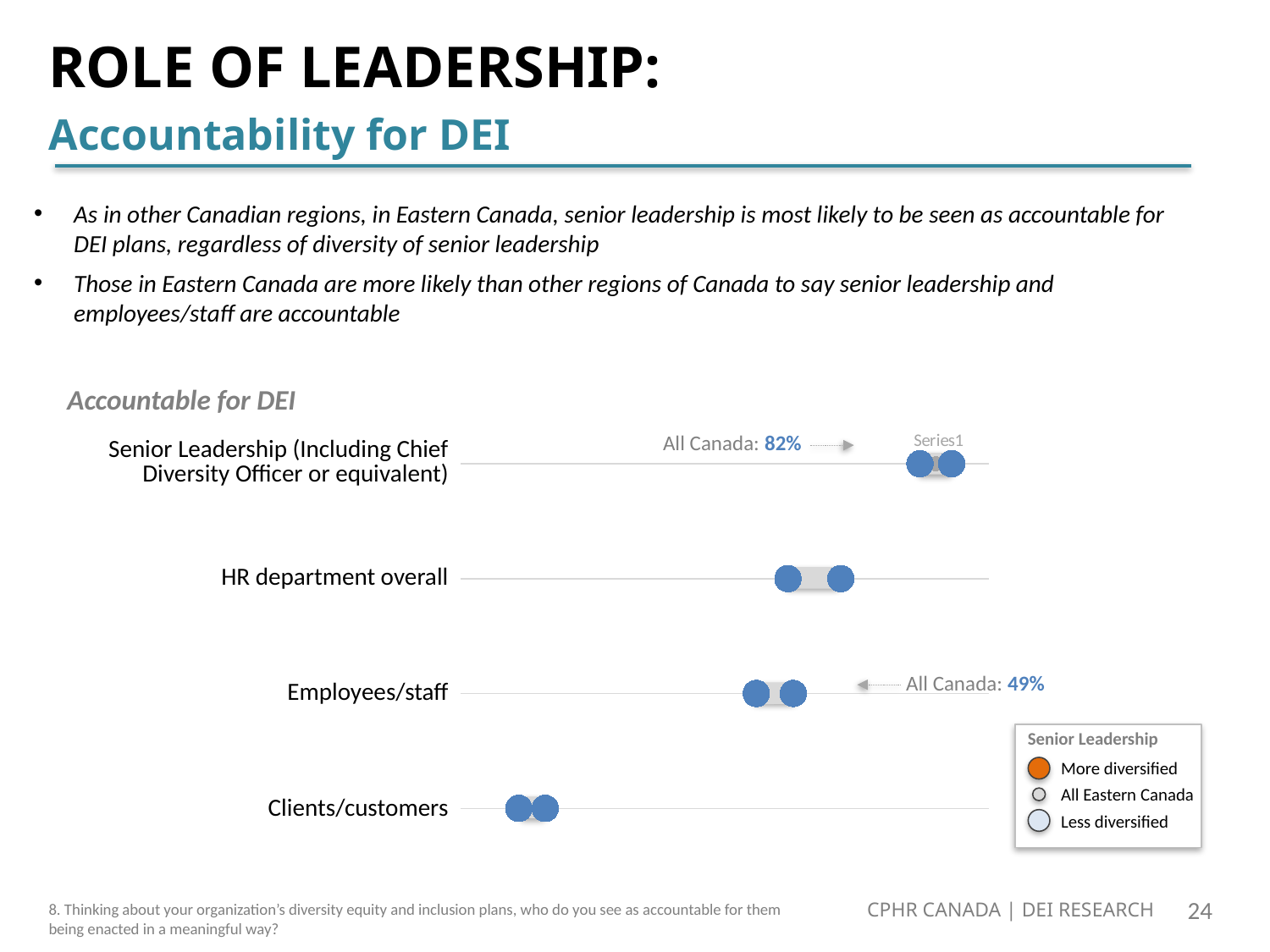
In the Accountable for DEI chart, which category has higher values: Clients/customers or Employees/staff? Employees/staff What All Canada value is annotated for Employees/staff in the Accountable for DEI chart? 49% What is the title of the chart on the slide? Accountable for DEI Which category in the Accountable for DEI chart has its markers positioned furthest to the right (highest)? Senior Leadership (Including Chief Diversity Officer or equivalent) How many categories are plotted in the Accountable for DEI chart? 4 In the Accountable for DEI chart, which category has higher values: HR department overall or Employees/staff? HR department overall What are the three entries listed in the Senior Leadership legend of the Accountable for DEI chart? More diversified, All Eastern Canada, Less diversified Which category in the Accountable for DEI chart has its markers positioned furthest to the left (lowest)? Clients/customers In the Accountable for DEI chart, what is the difference between the All Canada value for Senior Leadership (82%) and the All Canada value for Employees/staff (49%)? 33 percentage points What kind of chart is the Accountable for DEI chart? Dot plot How many entries are listed in the Senior Leadership legend of the Accountable for DEI chart? 3 What All Canada value is annotated for Senior Leadership (Including Chief Diversity Officer or equivalent) in the Accountable for DEI chart? 82%